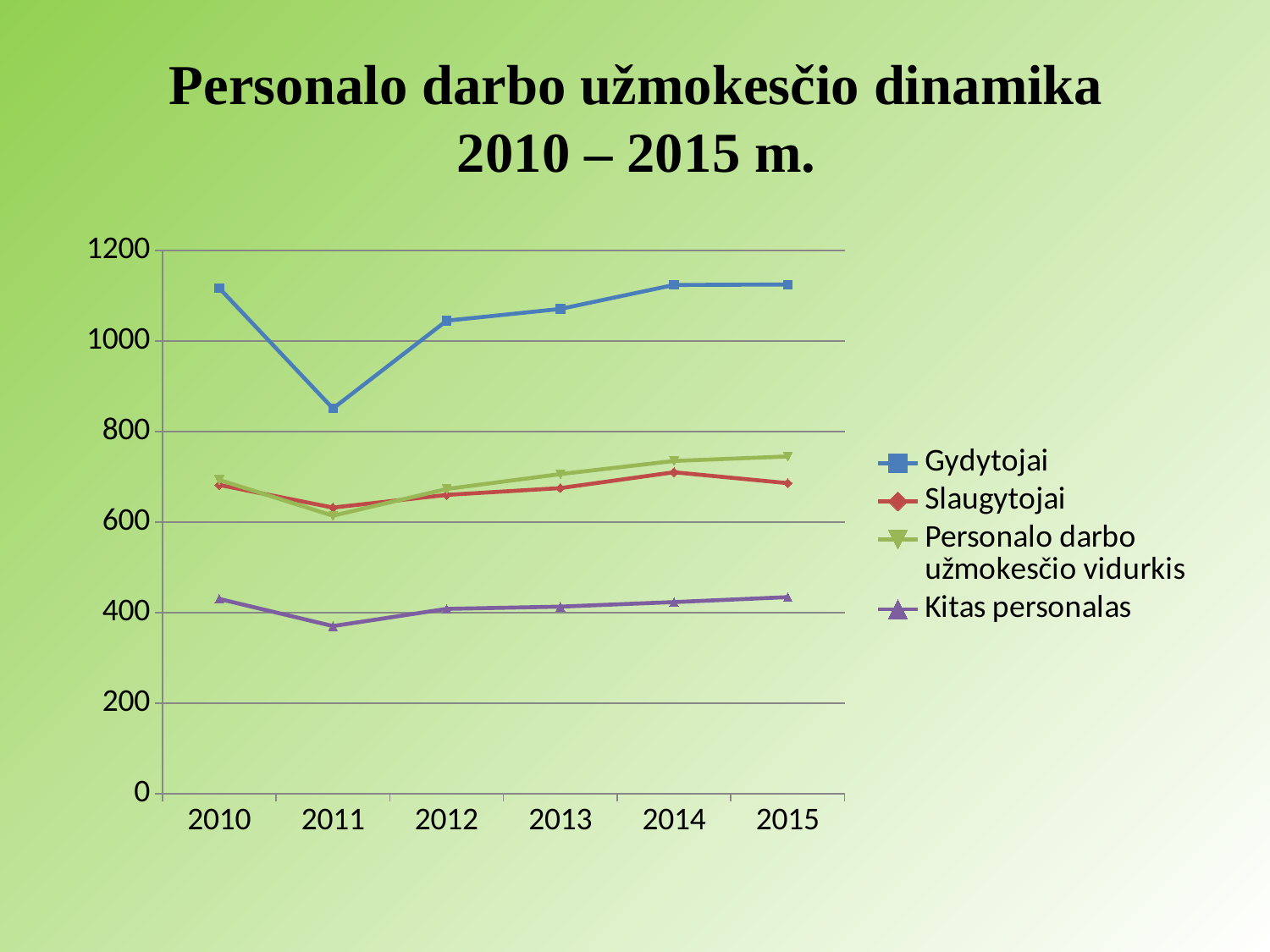
What kind of chart is shown on the slide? line chart Which is larger, the value for Gydytojai in 2010 or in 2011? 2010 In which year is the value for Gydytojai lowest? 2011 Is the value for Gydytojai in 2011 greater or less than 1000? less How many series does the legend list? 4 In which year is the value for Kitas personalas lowest? 2011 What is the title of the slide? Personalo darbo užmokesčio dinamika 2010 – 2015 m. Is the value for Gydytojai in 2015 greater or less than 1000? greater Which series has the highest values across all years? Gydytojai Is the value for Slaugytojai in 2014 greater or less than 800? less How many years are shown on the x axis? 6